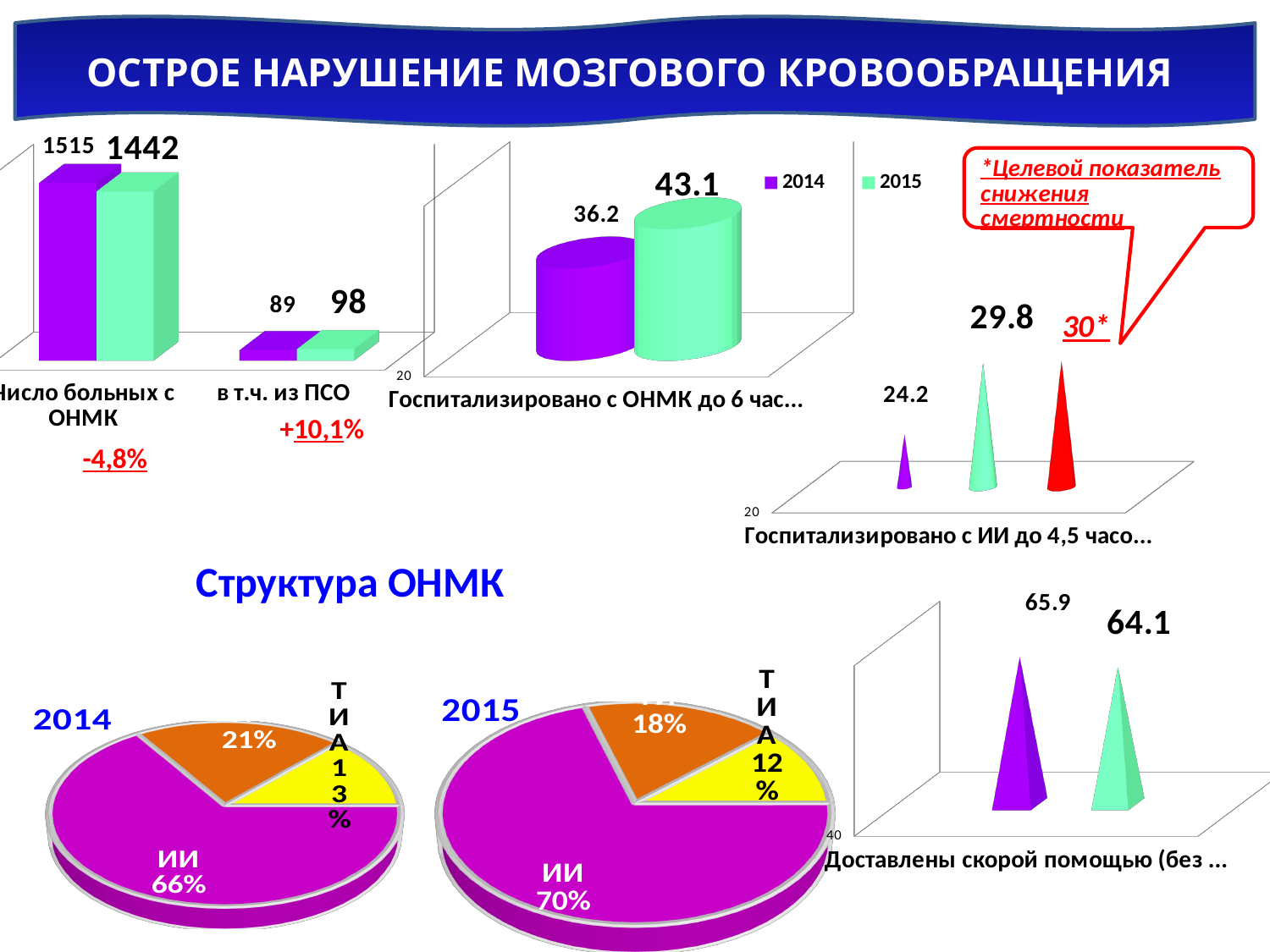
In the top-left bar chart, what is the 2015 value for "в т.ч. из ПСО"? 98 In the 2015 pie chart under "Структура ОНМК", what share does ТИА have? 12% In the chart "Госпитализировано с ИИ до 4,5 часо...", what is the target value shown on the red cone? 30* In the 2014 pie chart under "Структура ОНМК", what share does ИИ have? 66% In the top-left bar chart, what is the difference between the 2014 and 2015 values for "Число больных с ОНМК"? 73 In the top-left bar chart, what is the 2015 value for "Число больных с ОНМК"? 1442 In the chart "Госпитализировано с ОНМК до 6 час...", which year has the larger value, 2014 or 2015? 2015 In the top-left bar chart, what is the 2014 value for "Число больных с ОНМК"? 1515 In the chart "Госпитализировано с ОНМК до 6 час...", what is the value for 2015? 43.1 In the chart "Госпитализировано с ОНМК до 6 час...", how many series does the legend list? 2 In the chart "Госпитализировано с ИИ до 4,5 часо...", what is the value of the smallest (purple) cone? 24.2 In the chart "Доставлены скорой помощью (без ...", what is the value of the purple (2014) cone? 65.9